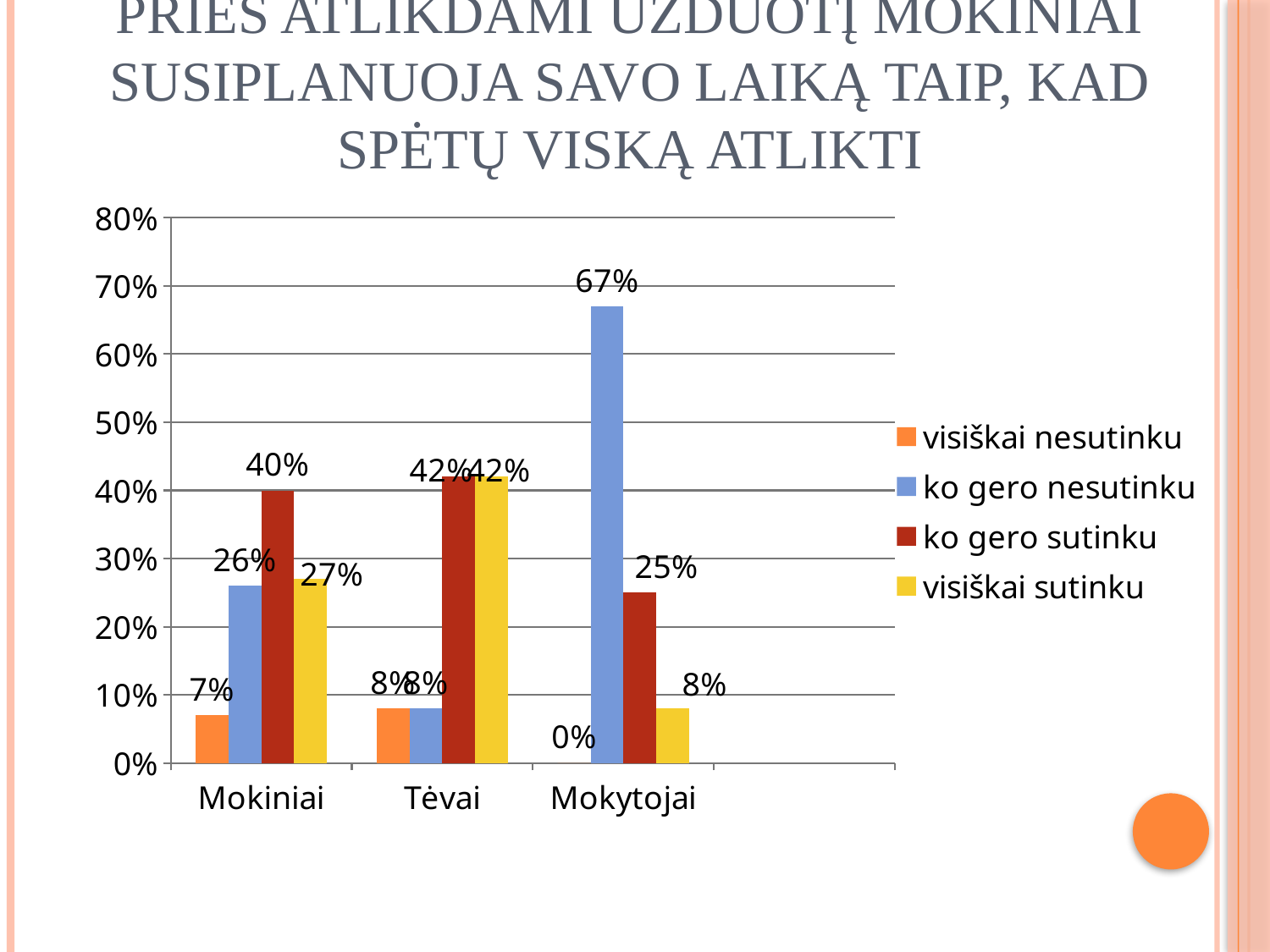
How many series does the legend list? 4 Is the value for "ko gero nesutinku" in the Mokytojai category greater or less than 60%? greater What kind of chart is shown on the slide? bar chart What is the difference between the "ko gero nesutinku" value for Mokytojai and for Mokiniai? 41% What is the value for "ko gero nesutinku" in the Mokytojai category? 67% How many categories are shown on the x axis? 3 Which category has the lowest value for "visiškai nesutinku"? Mokytojai Which is larger: the "ko gero sutinku" value for Mokiniai or for Mokytojai? Mokiniai Which category has the highest value for "ko gero nesutinku"? Mokytojai What is the value for "visiškai sutinku" in the Mokytojai category? 8% What is the value for "visiškai nesutinku" in the Mokiniai category? 7% What is the value for "ko gero sutinku" in the Tėvai category? 42%